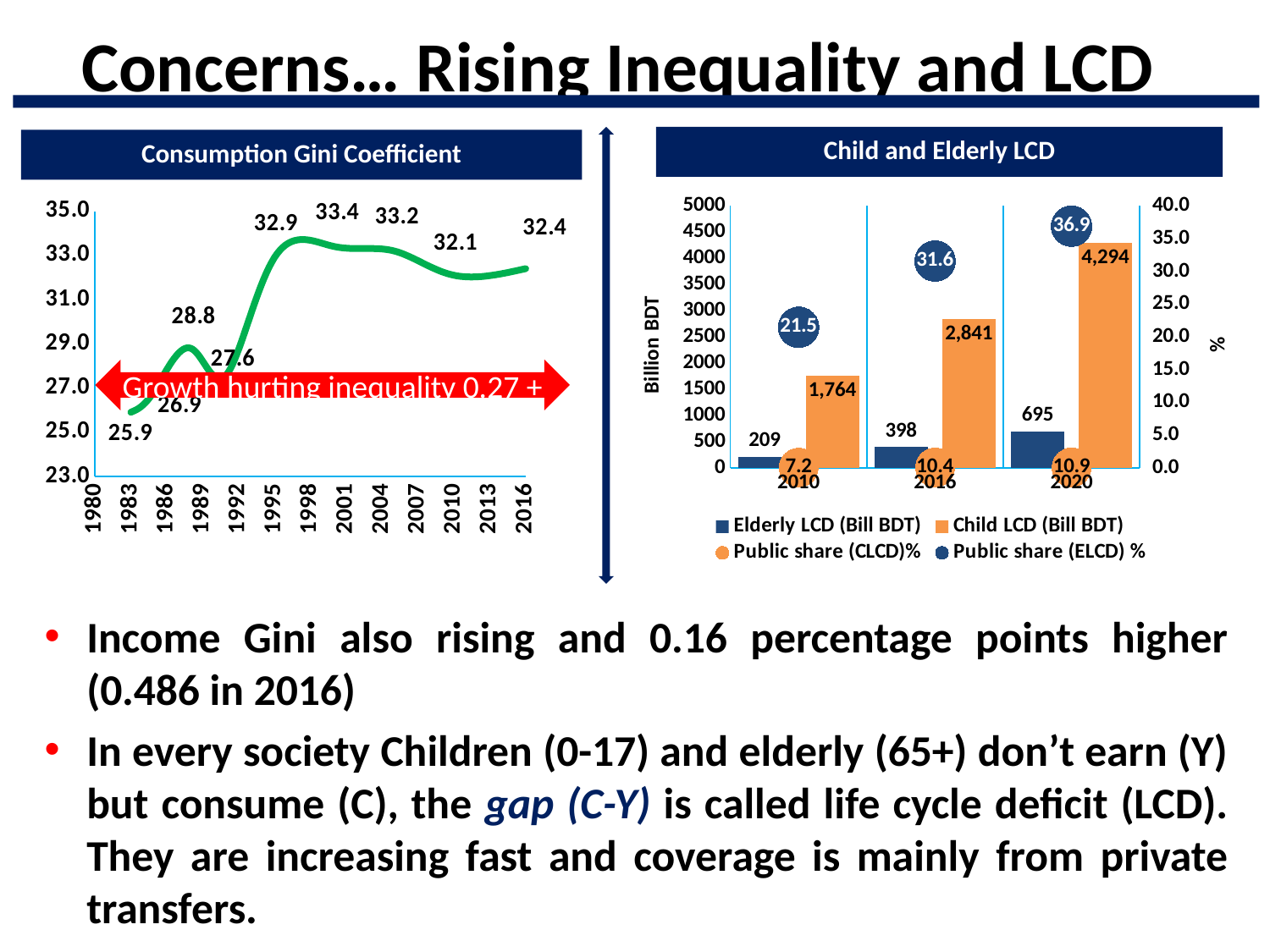
What kind of chart is the Consumption Gini Coefficient chart? line chart How many series does the legend of the Child and Elderly LCD chart list? 4 How many years are shown on the x axis of the Child and Elderly LCD chart? 3 In the Child and Elderly LCD chart, what is the Child LCD (Bill BDT) value for 2020? 4,294 In the Child and Elderly LCD chart, does the Child LCD rise or fall from 2010 to 2020? rise In the Child and Elderly LCD chart, which year has the larger Elderly LCD, 2016 or 2020? 2020 In the Child and Elderly LCD chart, what is the Public share (CLCD)% for 2010? 7.2 In the Child and Elderly LCD chart, what is the Elderly LCD (Bill BDT) value for 2010? 209 In the Child and Elderly LCD chart, what is the difference between Child LCD and Elderly LCD in 2016? 2,443 In the Child and Elderly LCD chart, what is the Public share (ELCD) % for 2016? 31.6 In the Consumption Gini Coefficient chart, what is the lowest labeled value? 25.9 In the Consumption Gini Coefficient chart, what is the highest labeled value? 33.4